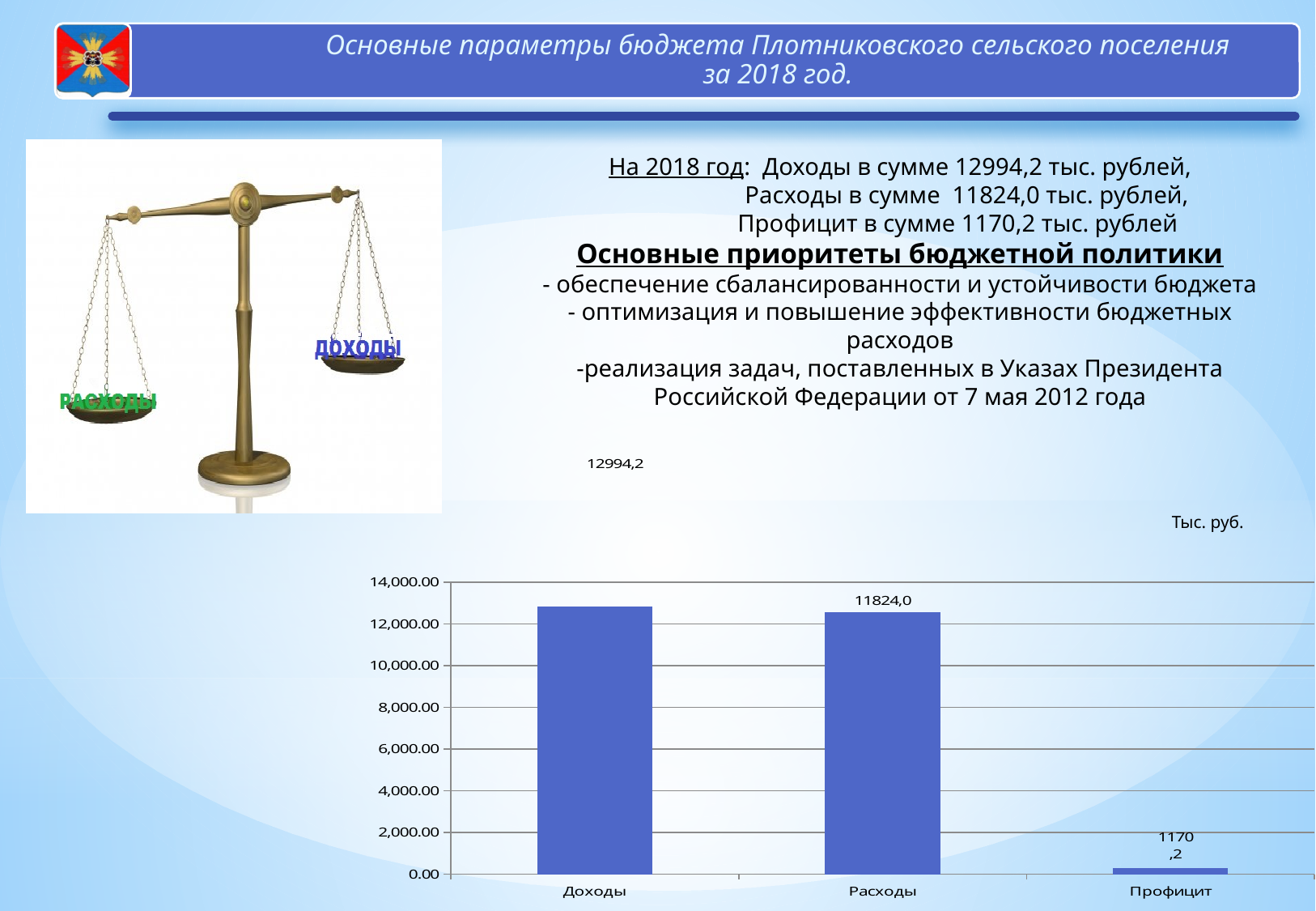
What is the value shown for Расходы in the bar chart? 11824,0 What is the value shown for Доходы in the bar chart? 12994,2 Which category has the highest value in the bar chart? Доходы Which is larger, the value for Доходы or the value for Расходы? Доходы What is the value shown for Профицит in the bar chart? 1170,2 What unit is indicated for the values in the bar chart? Тыс. руб. How many categories are plotted in the bar chart? 3 Which category has the lowest value in the bar chart? Профицит What is the difference between the values for Доходы and Расходы? 1170,2 What type of chart is shown on the slide? bar chart Is the value for Профицит greater or less than 2,000.00? less